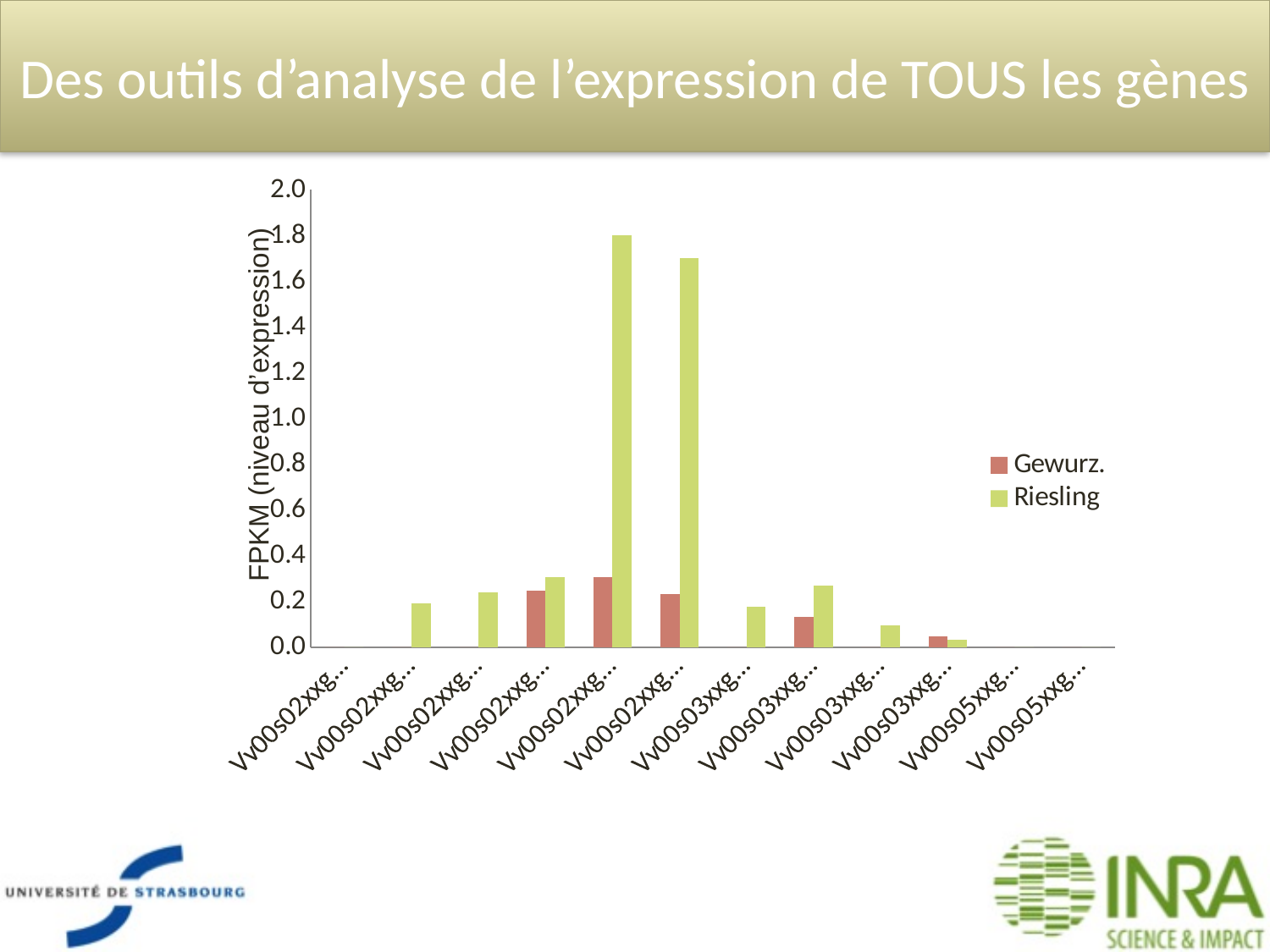
Is the Riesling value for the sixth category from the left greater or less than 1.4? greater Is the Riesling value for the fifth category from the left greater or less than 1.6? greater Which series has the tallest bar in the chart? Riesling What is the label of the vertical axis? FPKM (niveau d'expression) For the tenth category from the left, which series has the larger value, Gewurz. or Riesling? Gewurz. Is the Gewurz. value for the fifth category from the left greater or less than 0.6? less What is the highest value shown on the vertical axis? 2.0 For the fifth category from the left, which series has the larger value, Gewurz. or Riesling? Riesling What are the two series named in the legend? Gewurz. and Riesling What kind of chart is shown on the slide? bar chart How many series does the legend list? 2 How many categories are shown along the x axis? 12